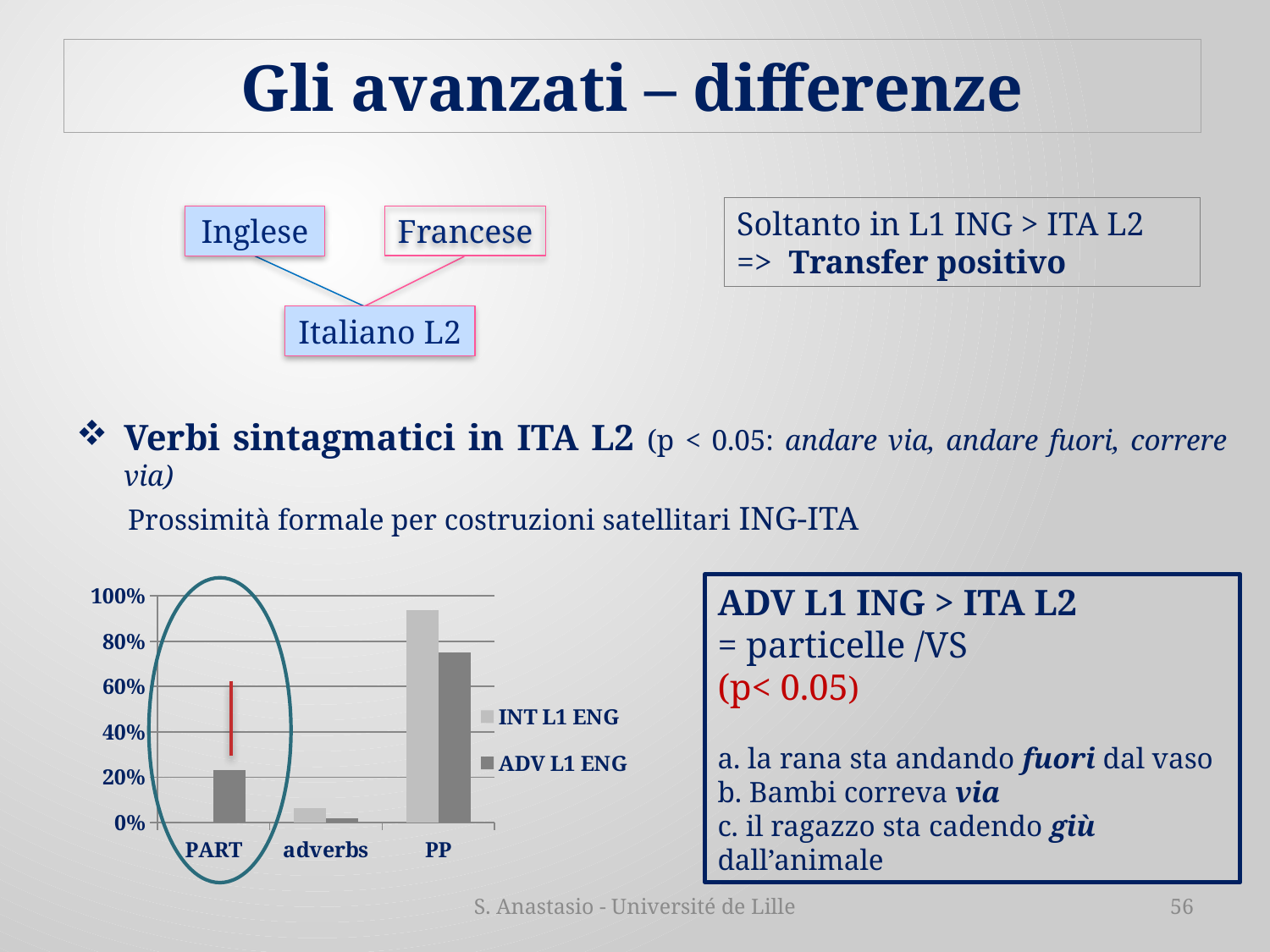
Which category on the chart is circled with an oval? PART How many series does the chart legend list? 2 How many categories are shown on the x axis of the chart? 3 Which category has the highest value for the INT L1 ENG series? PP For the PP category, which series has the larger value, INT L1 ENG or ADV L1 ENG? INT L1 ENG For the PART category, which series has the larger value, INT L1 ENG or ADV L1 ENG? ADV L1 ENG Is the ADV L1 ENG value for PART greater or less than 40%? less Is the ADV L1 ENG value for PP greater or less than 60%? greater Which category has the lowest value for the ADV L1 ENG series? adverbs What kind of chart is shown on the slide? bar chart Is the INT L1 ENG value for PP greater or less than 80%? greater Which category has the highest value for the ADV L1 ENG series? PP